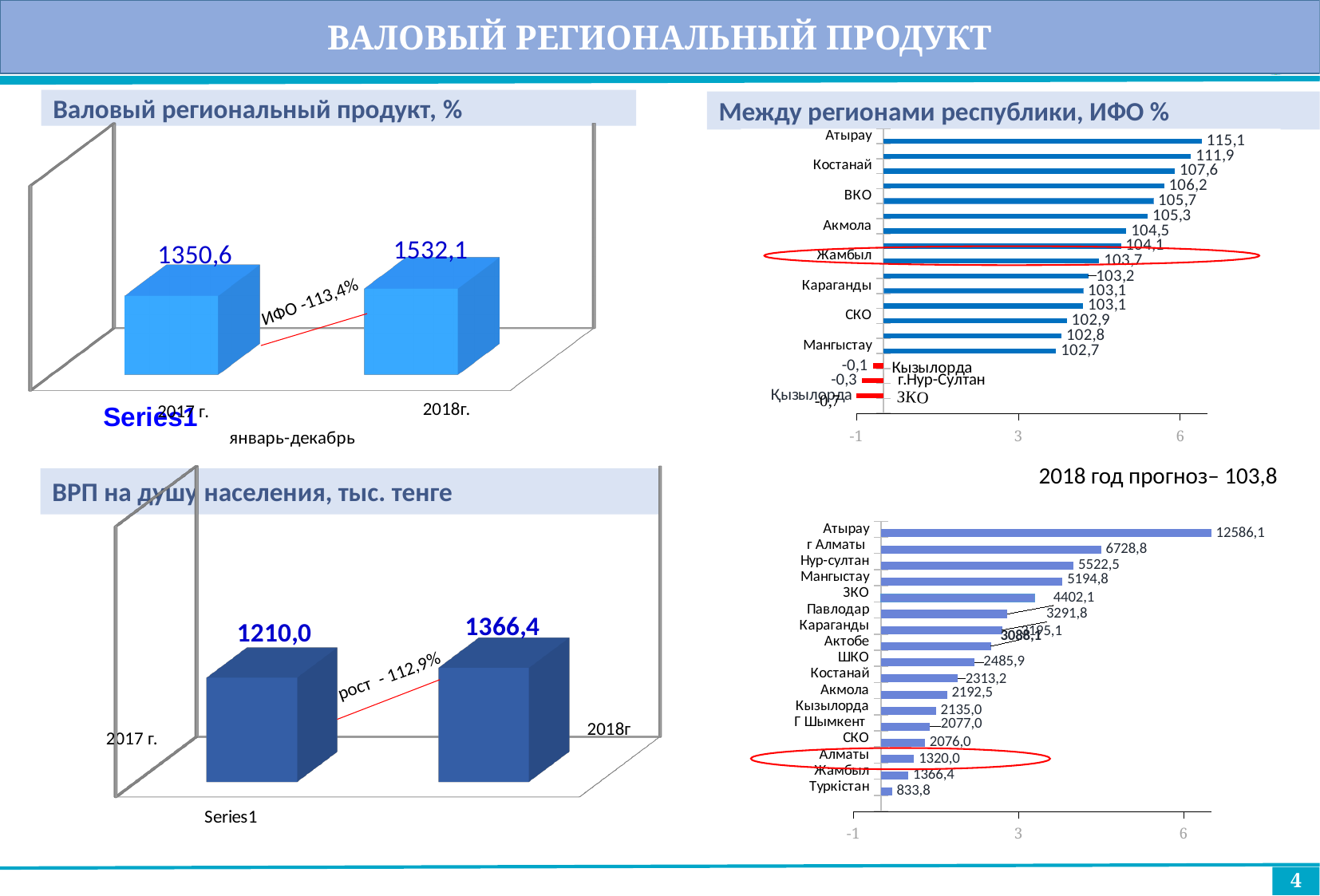
In the chart titled 'ВРП на душу населения, тыс. тенге', which year has the larger value, 2017 г. or 2018г? 2018г In the chart titled 'Валовый региональный продукт, %', what is the value for 2017 г.? 1350,6 In the bottom-right chart, what is the value for Атырау? 12586,1 In the chart titled 'Валовый региональный продукт, %', what is the value for 2018г.? 1532,1 In the chart titled 'Между регионами республики, ИФО %', what is the value for Атырау? 115,1 In the chart titled 'Между регионами республики, ИФО %', which region has the highest value? Атырау In the chart titled 'Между регионами республики, ИФО %', what is the value for Жамбыл? 103,7 In the chart titled 'Валовый региональный продукт, %', what is the difference between the 2018г. and 2017 г. values? 181,5 In the bottom-right chart, which region has the lowest value? Туркістан In the chart titled 'ВРП на душу населения, тыс. тенге', what is the value for 2017 г.? 1210,0 In the chart titled 'ВРП на душу населения, тыс. тенге', do the values rise or fall from 2017 г. to 2018г? rise In the chart titled 'ВРП на душу населения, тыс. тенге', what is the value for 2018г? 1366,4